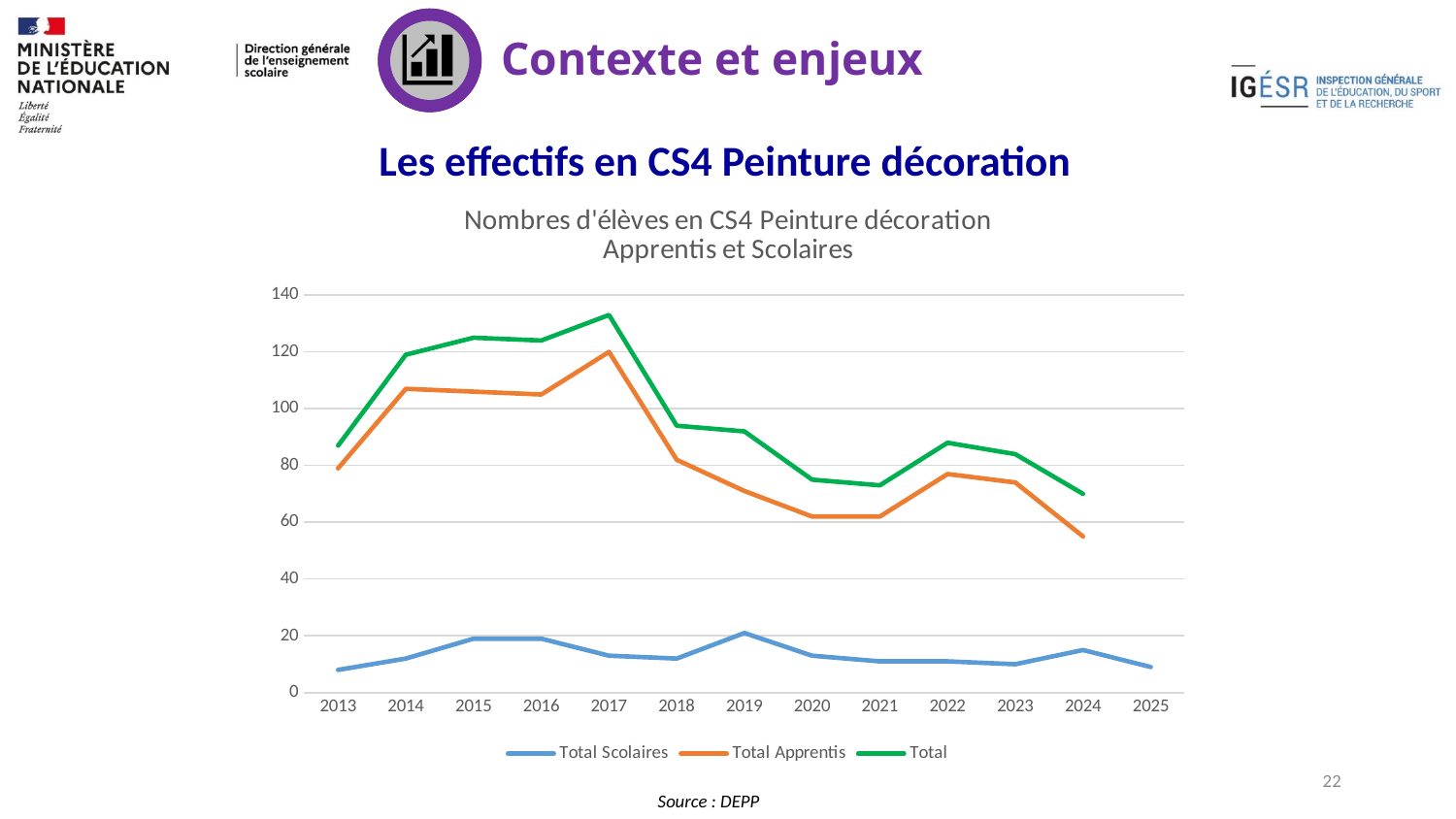
In which year does the Total Apprentis series reach its highest value? 2017 In which year does the Total Apprentis series reach its lowest value? 2024 How many series does the legend list? 3 Is the value for Total in 2014 greater or less than 100? greater In which year does the Total series reach its highest value? 2017 Is the value for Total Apprentis in 2020 greater or less than 80? less What is the title of the chart? Nombres d'élèves en CS4 Peinture décoration Apprentis et Scolaires Does the Total series rise or fall between 2017 and 2020? fall Which is larger, Total Apprentis in 2014 or Total Apprentis in 2018? 2014 Is the value for Total in 2017 greater or less than 120? greater What kind of chart is shown on the slide? line chart How many years are shown on the x axis? 13